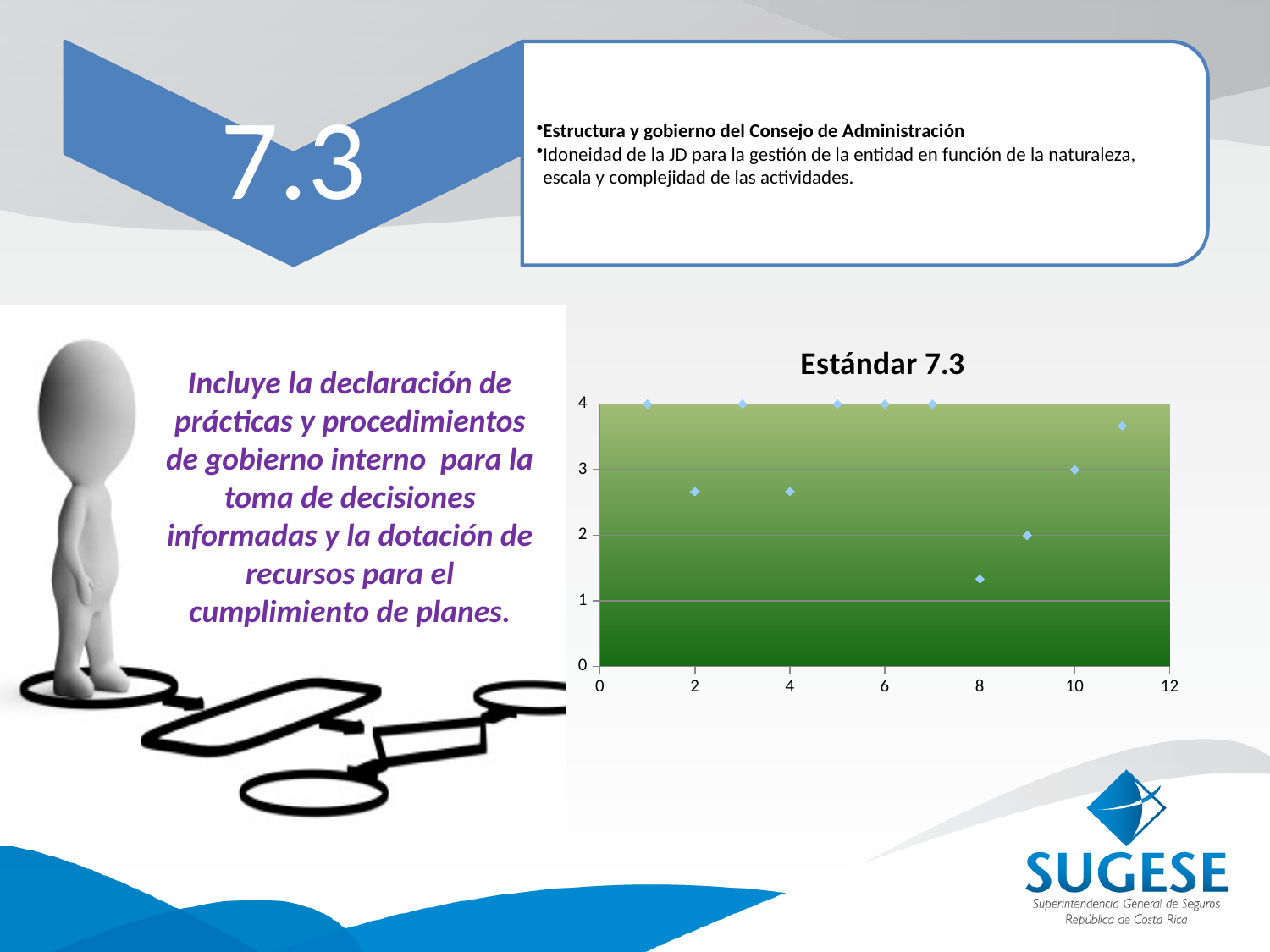
In the "Estándar 7.3" chart, is the y value of the point at x = 11 greater or less than 3? greater What is the title of the chart on the slide? Estándar 7.3 In the "Estándar 7.3" chart, what is the difference between the y values at x = 10 and x = 9? 1 In the "Estándar 7.3" chart, is the y value of the point at x = 2 greater or less than 2? greater In the "Estándar 7.3" chart, what is the y value of the point at x = 10? 3 In the "Estándar 7.3" chart, what is the y value of the point at x = 1? 4 In the "Estándar 7.3" chart, which point has the larger y value, the one at x = 9 or the one at x = 10? x = 10 How many data points are plotted in the "Estándar 7.3" chart? 11 In the "Estándar 7.3" chart, is the y value of the point at x = 8 greater or less than 2? less What type of chart is shown under the title "Estándar 7.3"? Scatter chart In the "Estándar 7.3" chart, which x position has the lowest y value? 8 In the "Estándar 7.3" chart, what is the y value of the point at x = 9? 2